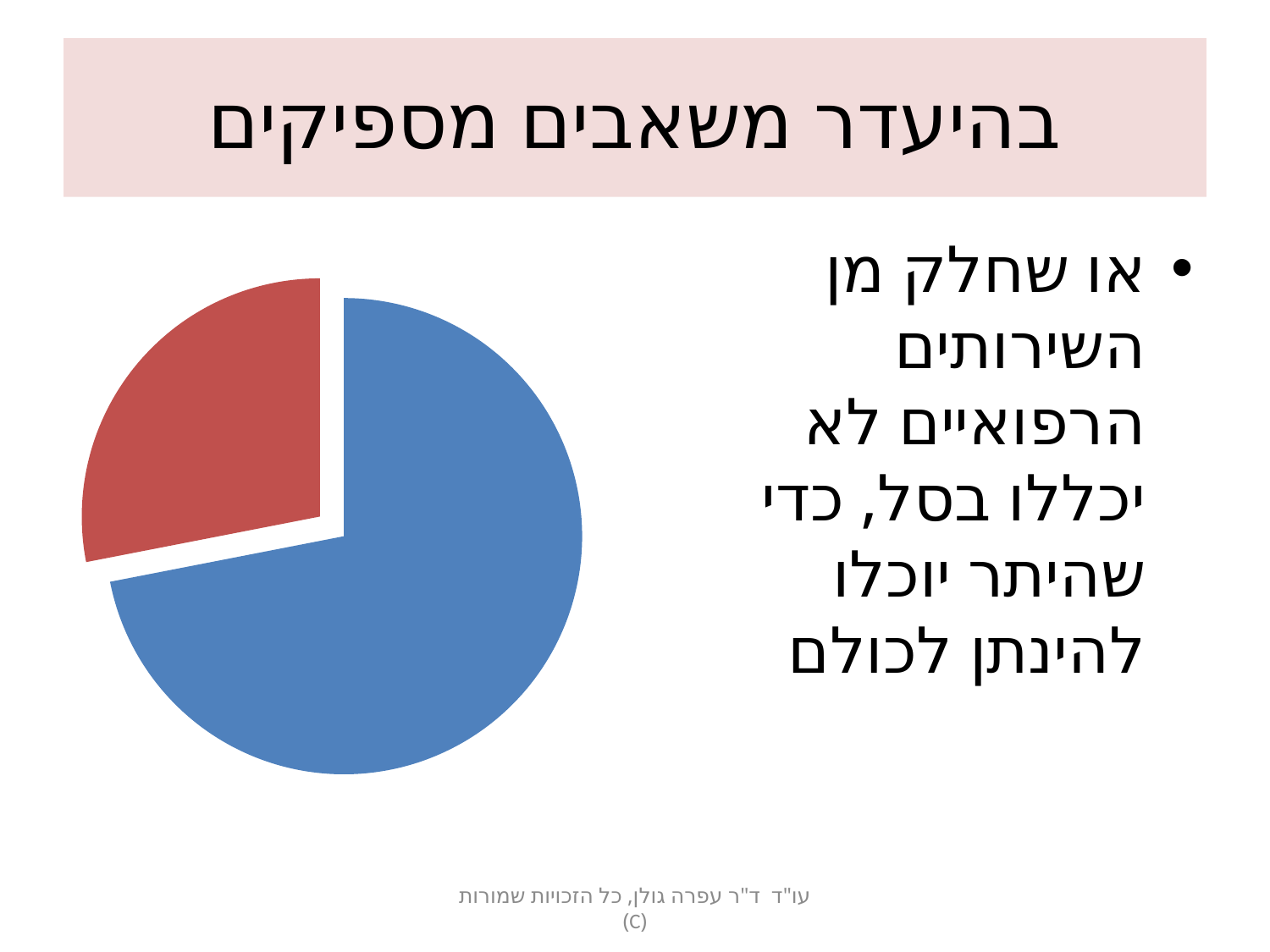
What kind of chart is shown on the slide? pie chart Which slice of the pie chart is pulled out (exploded) from the rest of the pie? the red slice What two colours are used for the slices of the pie chart? blue and red How many slices does the pie chart have? 2 Is the blue slice of the pie chart larger or smaller than the red slice? larger Which slice of the pie chart is the largest, the blue one or the red one? the blue one Which slice of the pie chart is the smallest, the blue one or the red one? the red one